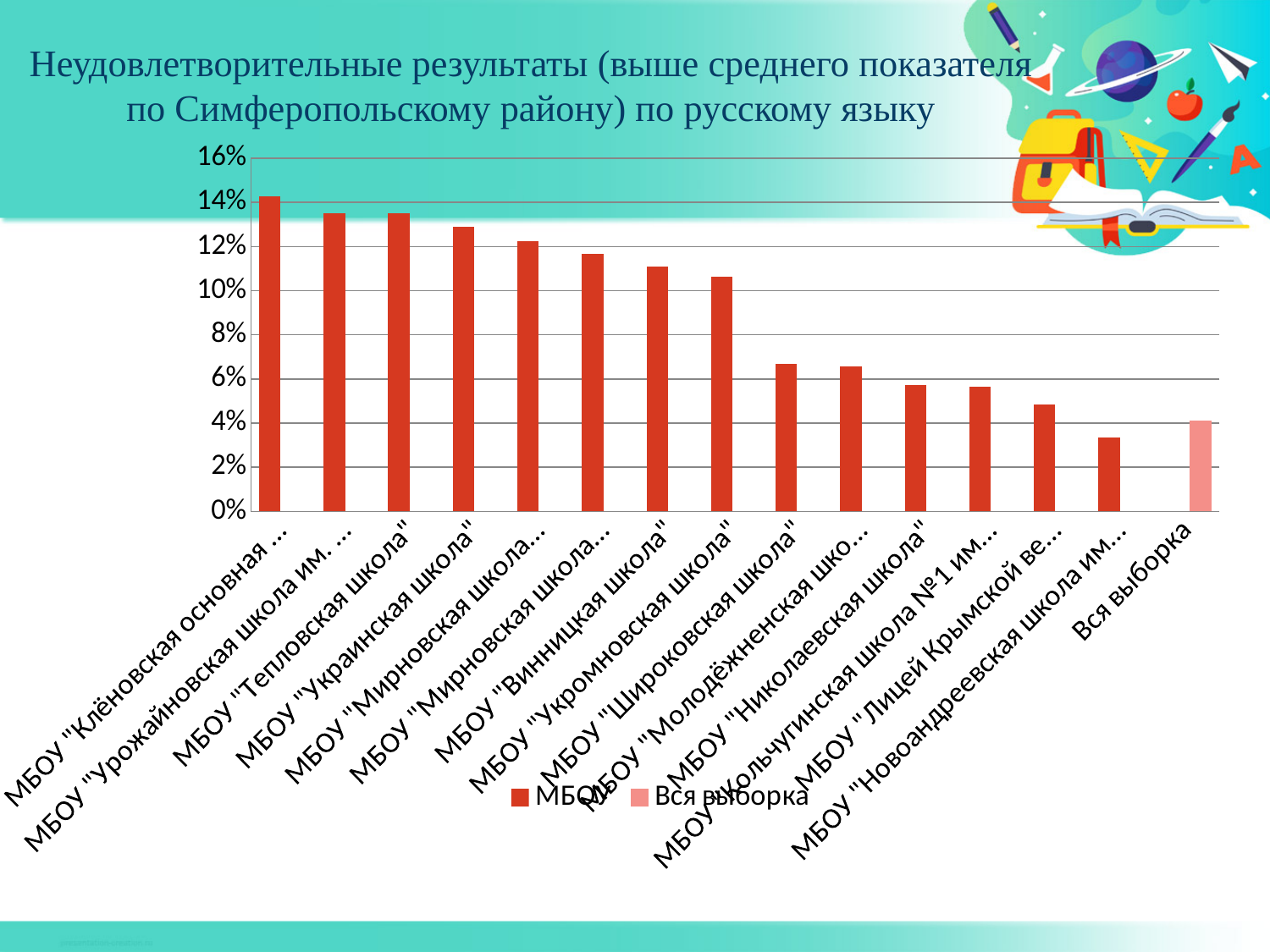
Which category has the lowest bar on the chart? МБОУ "Новоандреевская школа им..." How many series does the legend list? 2 Which is larger, the value for МБОУ "Винницкая школа" or for МБОУ "Широковская школа"? МБОУ "Винницкая школа" Is the value for Вся выборка greater or less than 6%? less Is the value for МБОУ "Клёновская основная ..." greater or less than 14%? greater What kind of chart is shown on the slide? bar chart Is the value for МБОУ "Тепловская школа" greater or less than 12%? greater What colour is the bar for Вся выборка? light pink Do the values of the МБОУ bars generally rise or fall from left to right along the x axis? fall How many bars (categories) are plotted on the chart? 15 Which category has the highest bar on the chart? МБОУ "Клёновская основная ..."